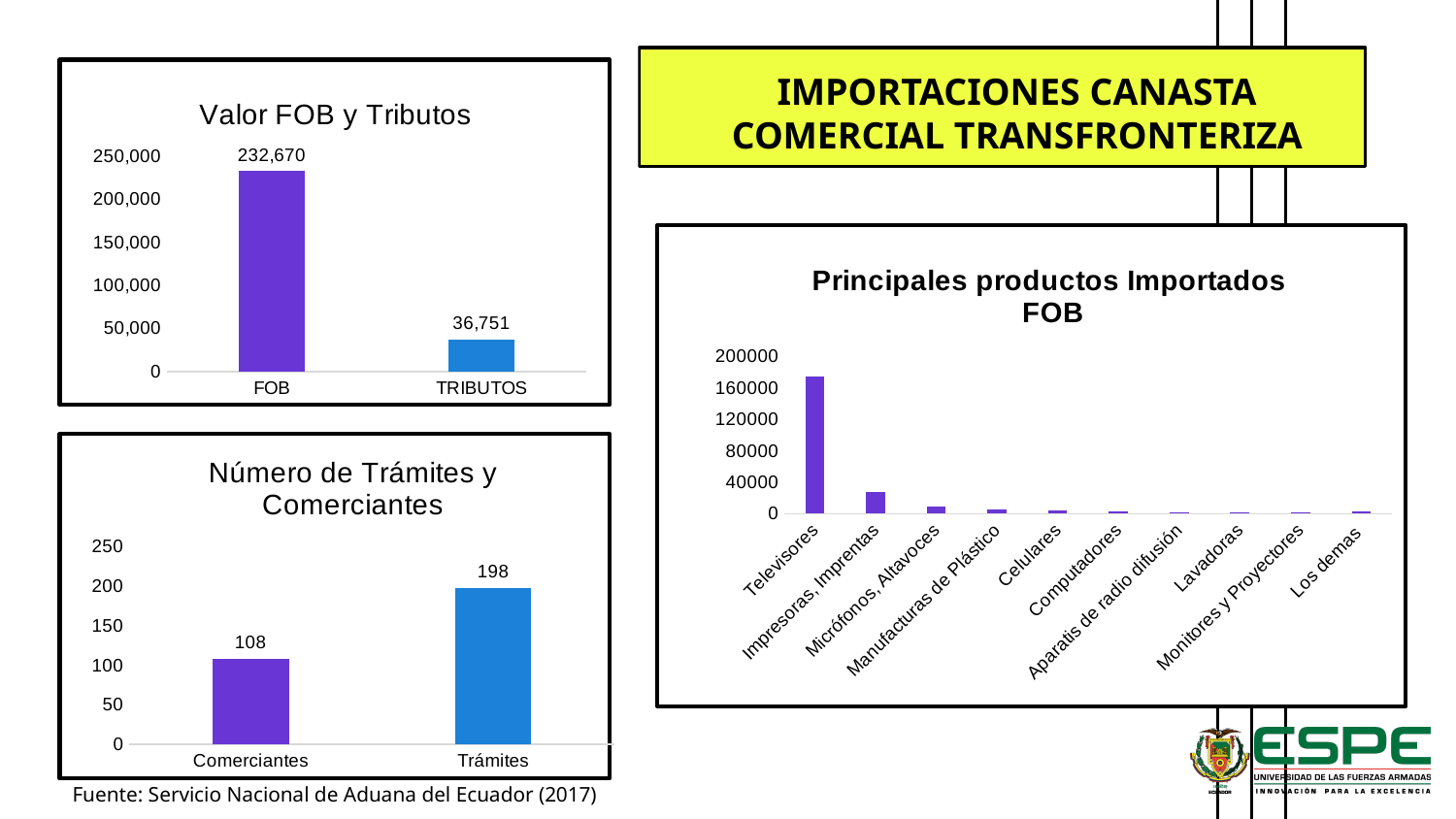
In the 'Principales productos Importados FOB' chart, how many product categories are shown? 10 In the 'Valor FOB y Tributos' chart, which category has the higher value? FOB In the 'Número de Trámites y Comerciantes' chart, what is the value for Comerciantes? 108 In the 'Valor FOB y Tributos' chart, what is the value for FOB? 232,670 In the 'Número de Trámites y Comerciantes' chart, what is the difference between Trámites and Comerciantes? 90 In the 'Principales productos Importados FOB' chart, is the value for Televisores greater or less than 160000? greater In the 'Principales productos Importados FOB' chart, is the value for Impresoras, Imprentas greater or less than 40000? less In the 'Número de Trámites y Comerciantes' chart, what is the value for Trámites? 198 In the 'Valor FOB y Tributos' chart, what is the value for TRIBUTOS? 36,751 In the 'Valor FOB y Tributos' chart, what is the difference between the FOB and TRIBUTOS values? 195,919 In the 'Principales productos Importados FOB' chart, which product has the highest value? Televisores In the 'Número de Trámites y Comerciantes' chart, which category has the lower value? Comerciantes